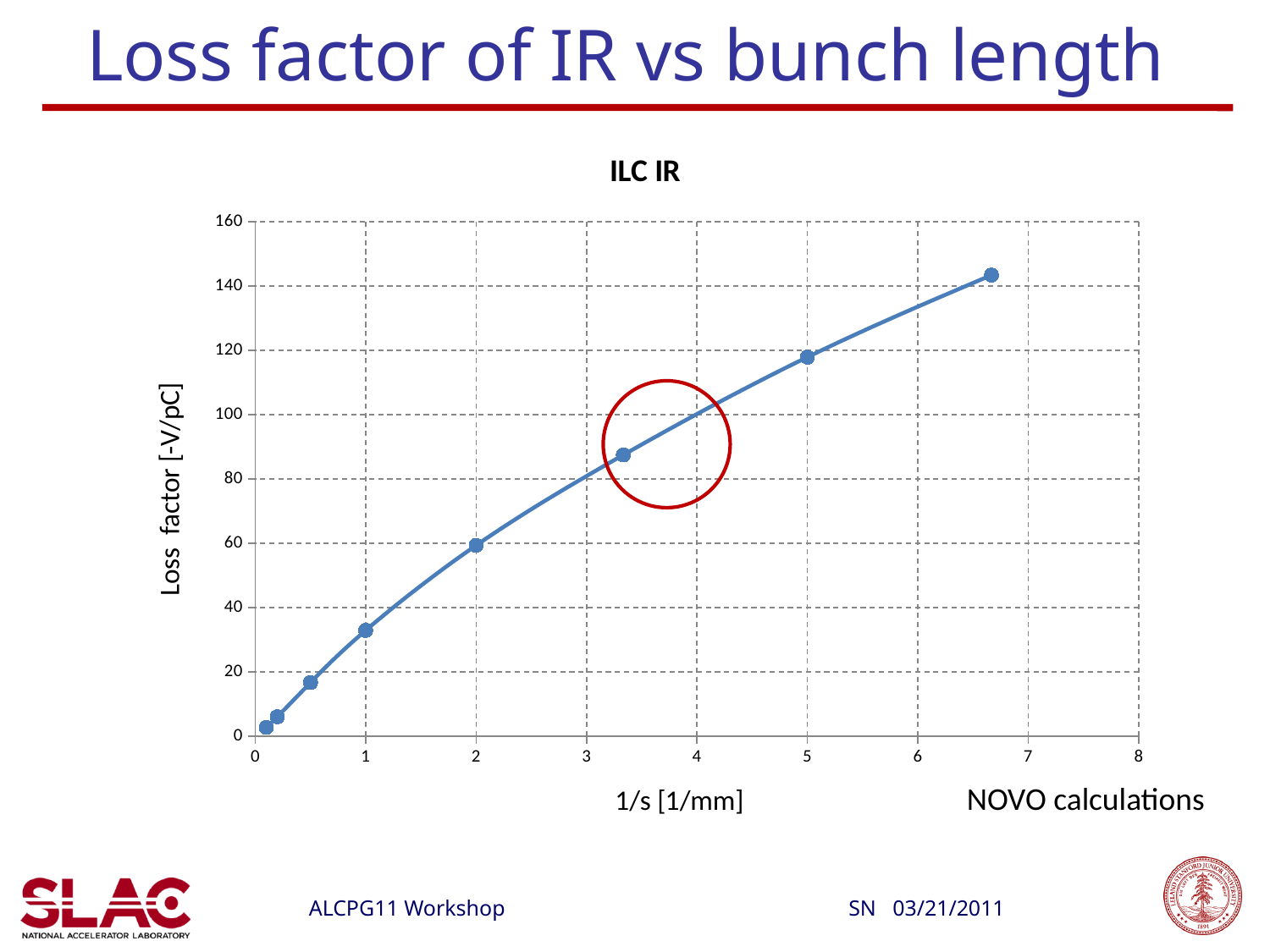
Is the loss factor at 1/s = 2 greater or less than 40? greater Does the loss factor rise or fall as 1/s increases along the x axis? rise Is the loss factor of the rightmost data point greater or less than 120? greater How many data points are plotted on the chart? 8 Is the loss factor at 1/s = 1 greater or less than 40? less What is the label of the y axis? Loss factor [-V/pC] What is the title of the chart? ILC IR What type of chart is shown on the slide? line chart Which data point has the highest loss factor, the leftmost or the rightmost? rightmost